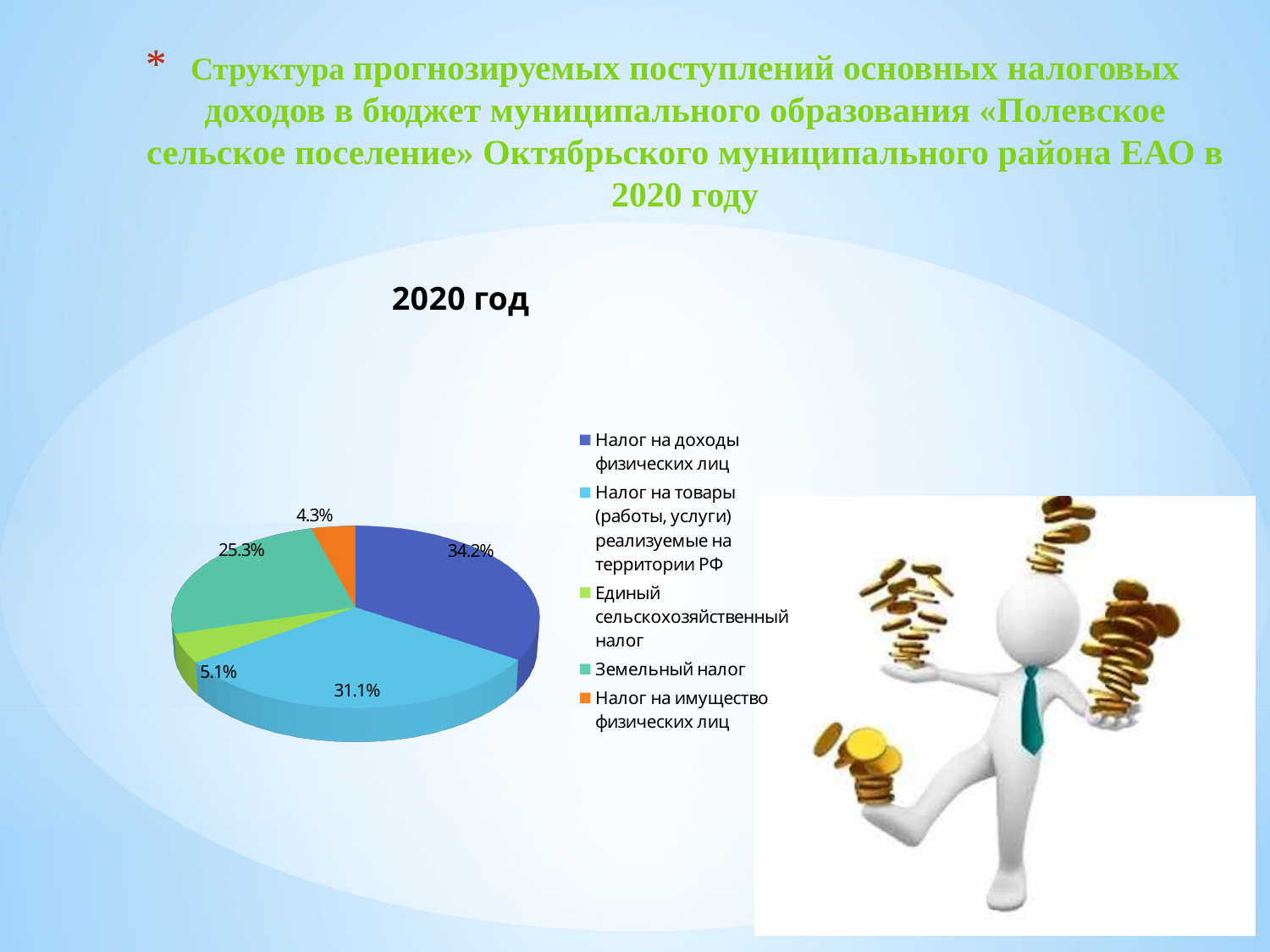
Which category has the smallest share of the pie? Налог на имущество физических лиц What share of the pie is Налог на доходы физических лиц? 34.2% What share of the pie is Налог на имущество физических лиц? 4.3% What share of the pie is Налог на товары (работы, услуги) реализуемые на территории РФ? 31.1% How many categories does the pie chart have? 5 What kind of chart is shown on the slide? pie chart Which category has the largest share of the pie? Налог на доходы физических лиц What is the difference between the shares of Налог на доходы физических лиц and Земельный налог? 8.9% What share of the pie is Земельный налог? 25.3% Which is larger, the share of Земельный налог or the share of Единый сельскохозяйственный налог? Земельный налог What is the chart's title? 2020 год What share of the pie is Единый сельскохозяйственный налог? 5.1%